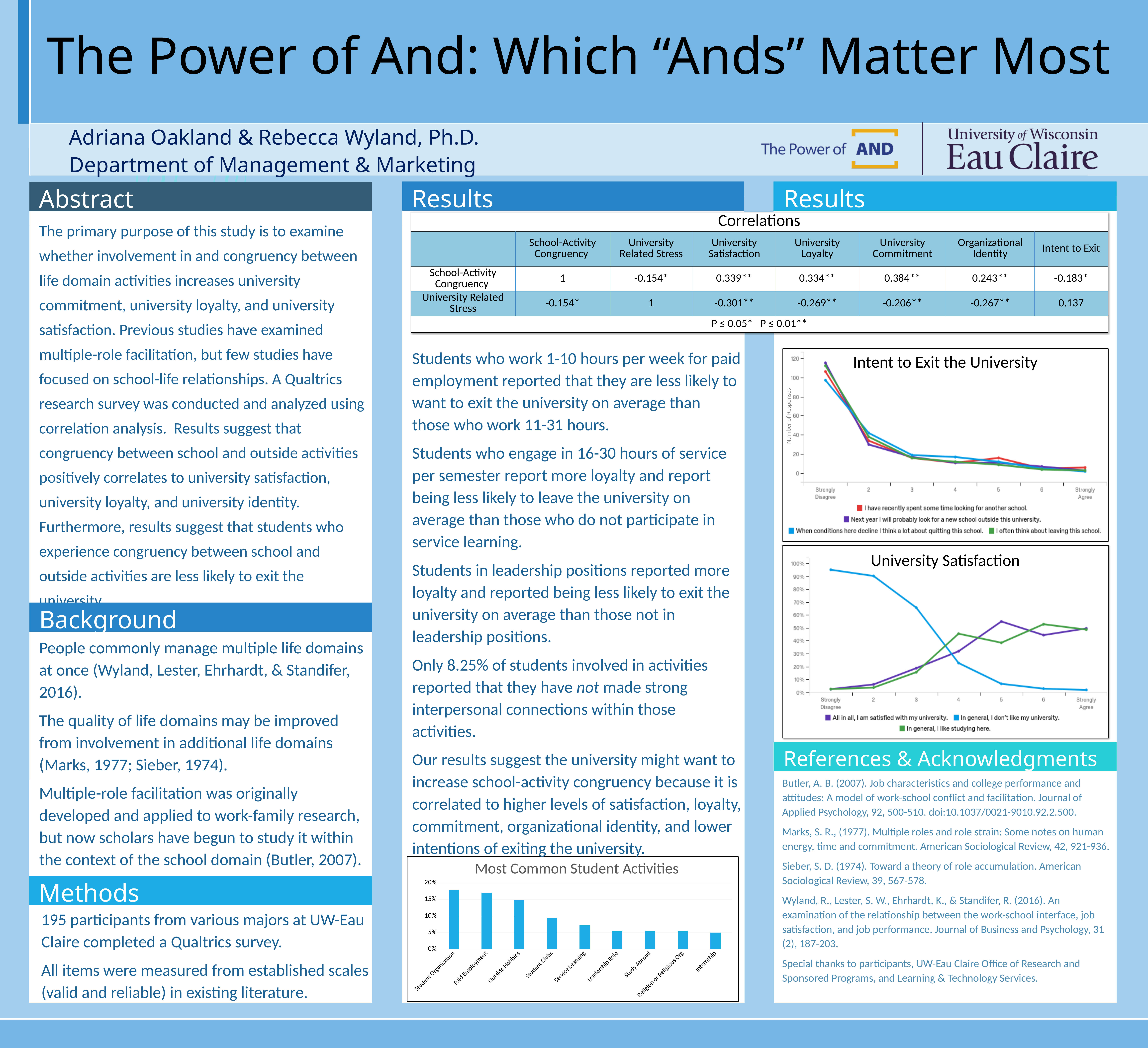
In the "Most Common Student Activities" chart, which is larger, Paid Employment or Study Abroad? Paid Employment In the "Most Common Student Activities" chart, how many activities are shown? 9 What kind of chart is "Intent to Exit the University"? line chart In the "Most Common Student Activities" chart, which activity has the highest value? Student Organization What kind of chart is "Most Common Student Activities"? bar chart In the "Most Common Student Activities" chart, do the values rise or fall from left to right? fall In the "University Satisfaction" chart, is the value for "In general, I don't like my university" at Strongly Disagree greater or less than 90%? greater How many series does the legend of the "Intent to Exit the University" chart list? 4 In the "Most Common Student Activities" chart, is the value for Student Clubs greater or less than 10%? less How many series does the legend of the "University Satisfaction" chart list? 3 In the "Intent to Exit the University" chart, do the lines rise or fall from Strongly Disagree to Strongly Agree? fall In the "Most Common Student Activities" chart, is the value for Student Organization greater or less than 15%? greater